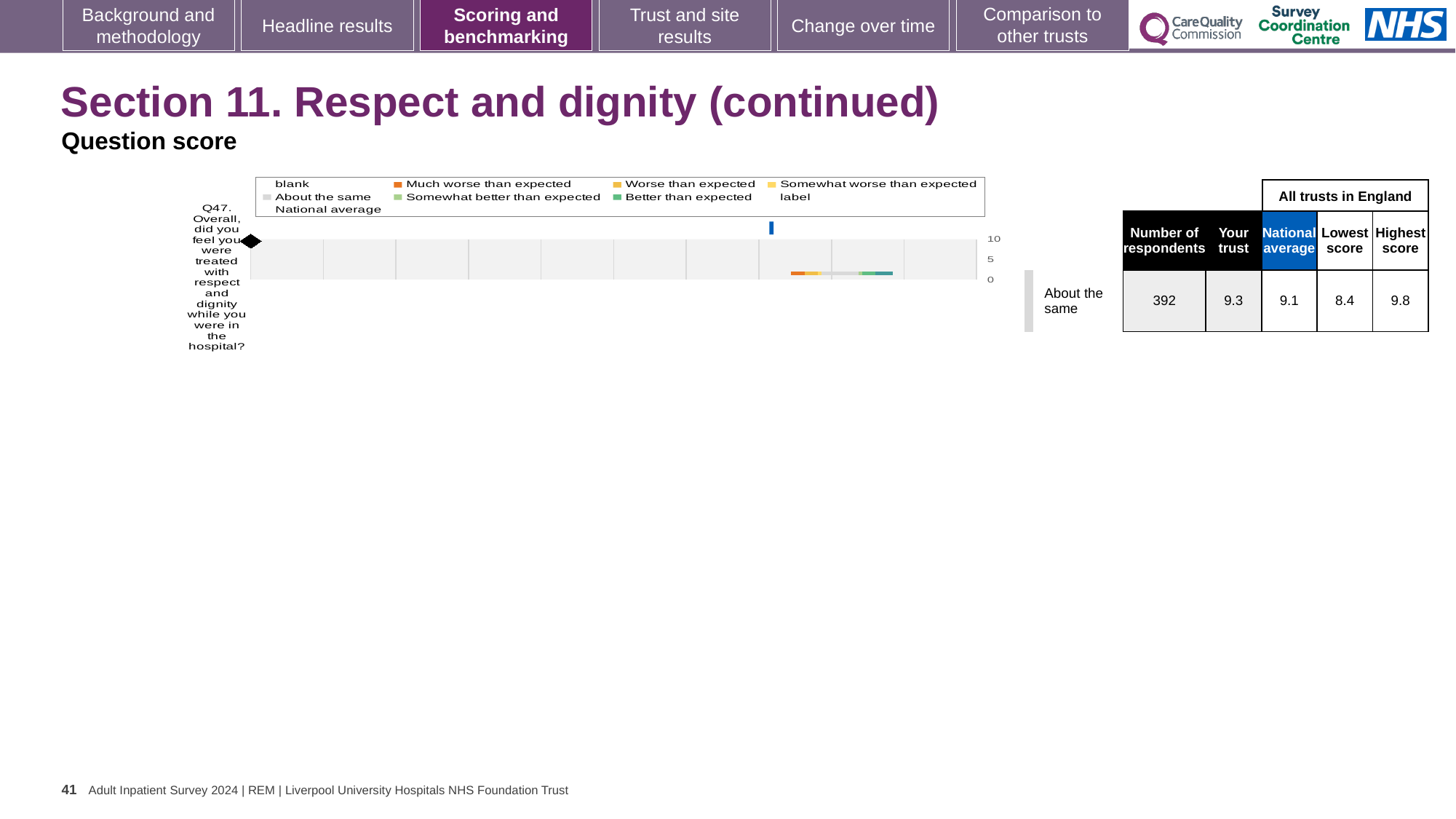
What is the highest value shown on the chart's axis? 10 How many survey questions are plotted on the chart? 1 How many respondents answered Q47? 392 Which question number is plotted on the chart? Q47 What benchmark category is the trust's Q47 score assigned to? About the same What is the lowest score among all trusts in England for Q47? 8.4 What is the highest score among all trusts in England for Q47? 9.8 What is the national average score for Q47? 9.1 What is the 'Your trust' score for Q47? 9.3 What is the difference between the 'Your trust' score and the national average for Q47? 0.2 Which is larger for Q47, the 'Your trust' score or the national average? Your trust What kind of chart is shown on the slide? bar chart